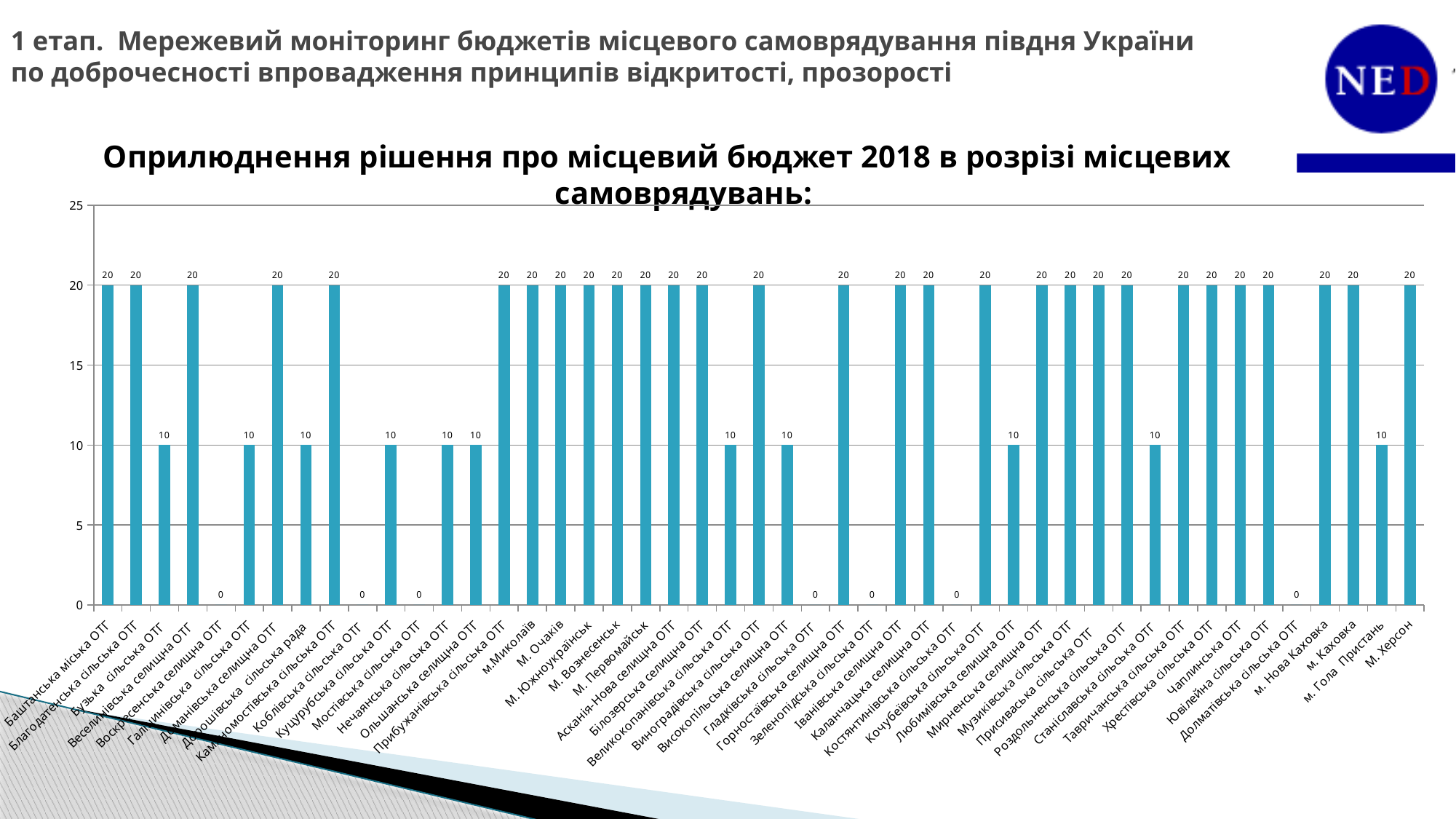
What kind of chart is shown on the slide? bar chart What value is shown for м. Херсон? 20 What is the highest value reached by any bar in the chart? 20 What is the title of the chart? Оприлюднення рішення про місцевий бюджет 2018 в розрізі місцевих самоврядувань: What value is shown for Мирненська селищна ОТГ? 20 What value is shown for Воскресенська селищна ОТГ? 0 How many categories have a value of 0? 7 Is the value for Тавричанська сільська ОТГ greater or less than 15? greater What is the difference between the values for м.Миколаїв and Куцурубська сільська ОТГ? 10 Which has the larger value, Веселинівська селищна ОТГ or Галицинівська сільська ОТГ? Веселинівська селищна ОТГ What value is shown for м. Гола Пристань? 10 What value is shown for Бузька сільська ОТГ? 10